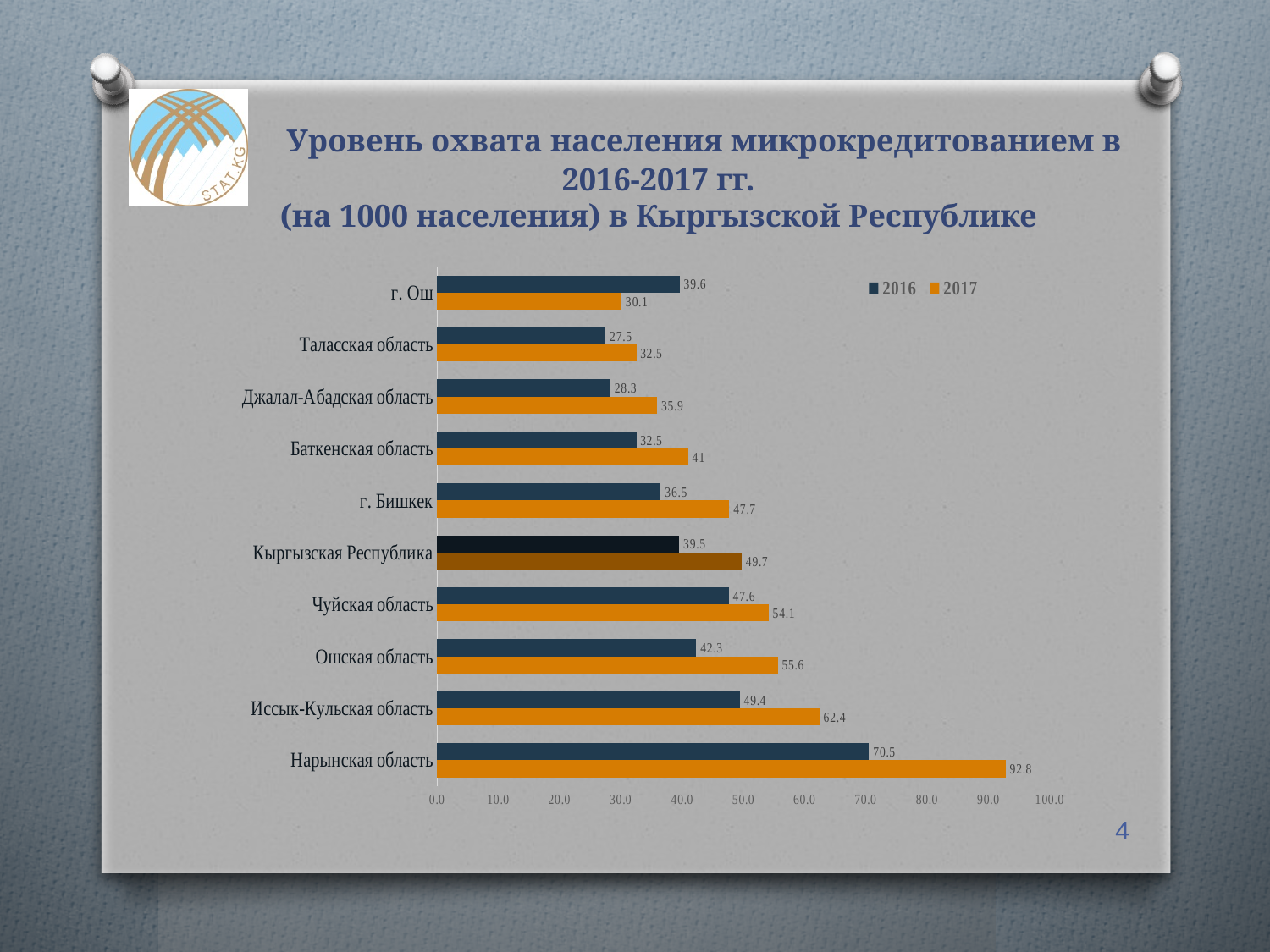
Which category has the lowest 2016 value? Таласская область How many series does the legend list? 2 Which category has the highest 2017 value? Нарынская область What is the difference between the 2017 and 2016 values for Иссык-Кульская область? 13 What is the 2017 value for Кыргызская Республика? 49.7 Which colour represents the 2017 series in the chart? Orange How many categories are shown on the chart? 10 What kind of chart is shown on the slide? Bar chart Is the 2017 value for Ошская область greater or less than 50.0? greater Which is larger for г. Ош, the 2016 value or the 2017 value? 2016 What is the 2016 value for г. Бишкек? 36.5 What is the 2017 value for Нарынская область? 92.8